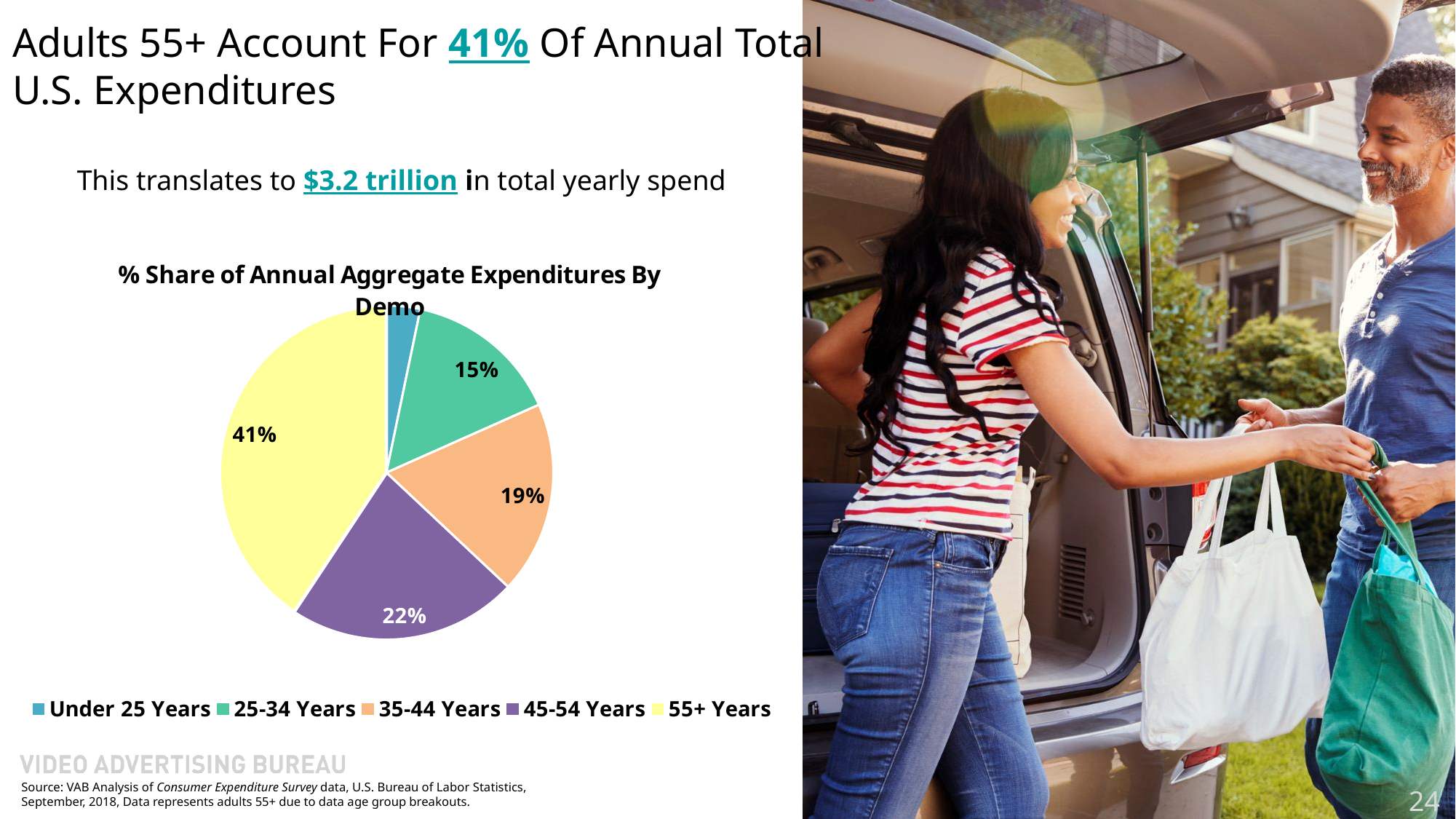
What is the value for the 25-34 Years slice in the pie chart? 15% How many percentage points larger is the 55+ Years share than the 45-54 Years share? 19 percentage points How many age groups are shown in the pie chart? 5 Which age group has the smallest slice in the pie chart? Under 25 Years Which is larger, the share for 35-44 Years or the share for 25-34 Years? 35-44 Years Which age group has the largest share of annual aggregate expenditures? 55+ Years How many entries does the chart legend list? 5 What percentage share is shown for the 35-44 Years group? 19% What share of annual aggregate expenditures does the 55+ Years group account for? 41% What type of chart is used on this slide? Pie chart What is the title of the chart? % Share of Annual Aggregate Expenditures By Demo What is the value shown for the 45-54 Years slice? 22%